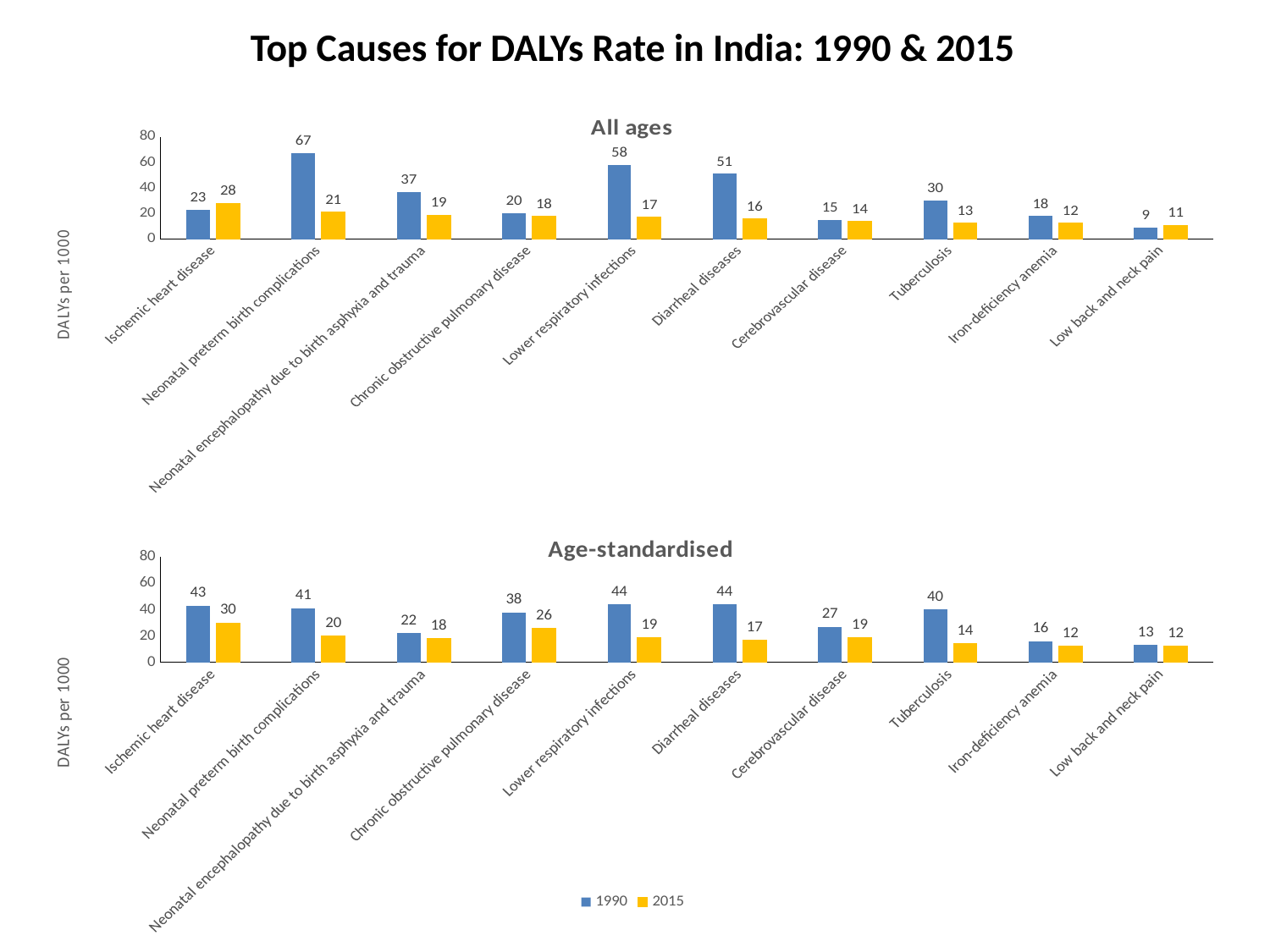
In the 'All ages' chart, which cause has the highest 1990 value? Neonatal preterm birth complications How many causes are shown on the x axis of the 'Age-standardised' chart? 10 In the 'Age-standardised' chart, what is the difference between the 1990 and 2015 values for Tuberculosis? 26 In the 'Age-standardised' chart, which cause has the highest 2015 value? Ischemic heart disease In the 'Age-standardised' chart, what is the 2015 value for Chronic obstructive pulmonary disease? 26 In the 'All ages' chart, which cause has the lowest 1990 value? Low back and neck pain In the 'All ages' chart, what is the difference between the 1990 and 2015 values for Lower respiratory infections? 41 How many series does the legend list? 2 What type of chart is the 'All ages' chart? Bar chart In the 'All ages' chart, which is larger for Low back and neck pain: the 1990 value or the 2015 value? 2015 In the 'All ages' chart, what is the 1990 value for Neonatal preterm birth complications? 67 In the 'All ages' chart, what is the 2015 value for Ischemic heart disease? 28